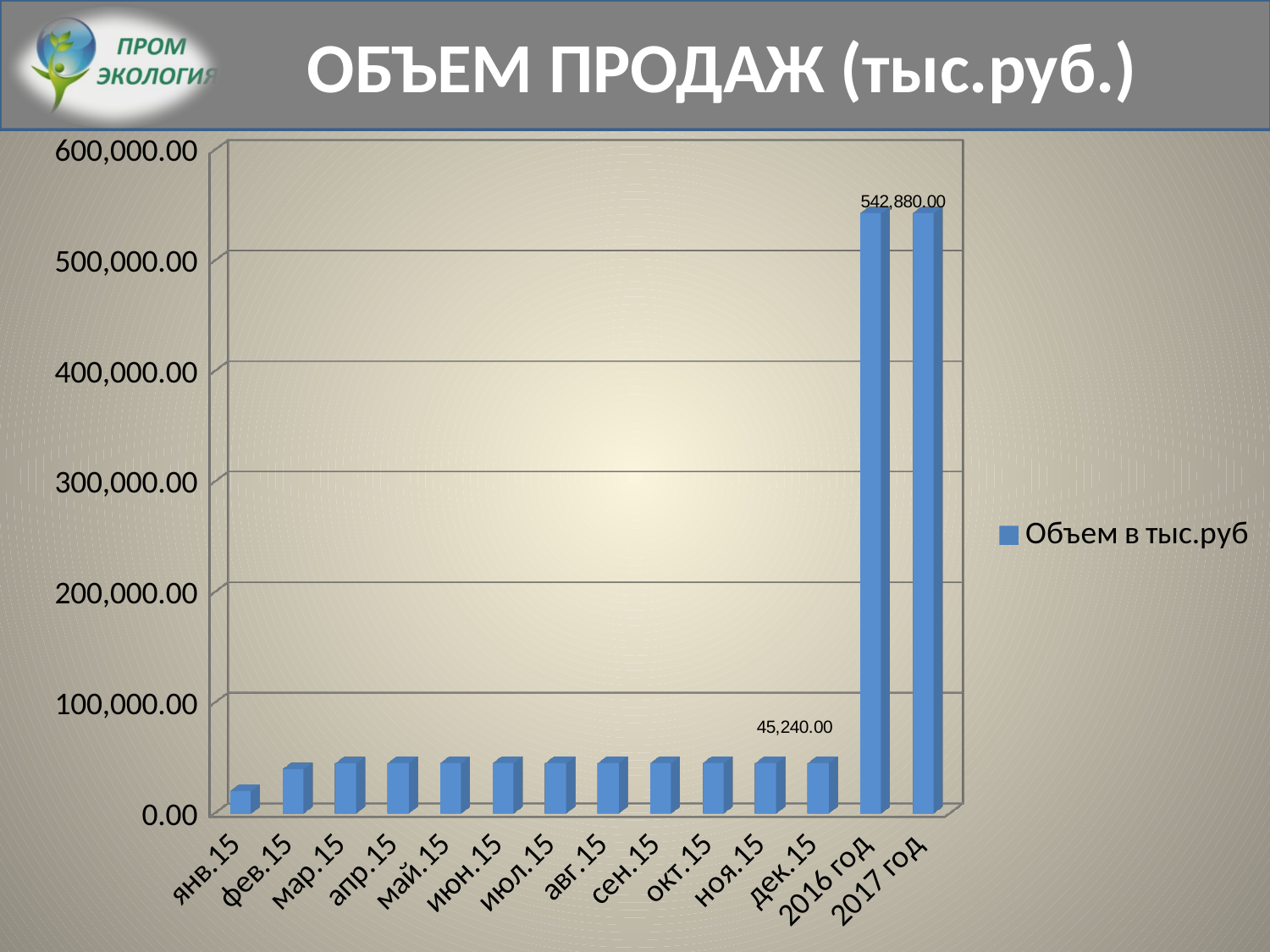
Is the value for 2017 год greater or less than 500,000.00? greater Is the value for июн.15 greater or less than 100,000.00? less What kind of chart is shown on the slide? bar chart Which is larger, the value for 2016 год or the value for дек.15? 2016 год Is the value for янв.15 greater or less than 100,000.00? less What is the title of the slide chart? ОБЪЕМ ПРОДАЖ (тыс.руб.) How many series does the chart legend list? 1 What value is printed as the data label next to the tallest bars in the chart? 542,880.00 What is the legend entry of the chart? Объем в тыс.руб How many categories are shown along the x axis of the chart? 14 Which category has the lowest value in the chart? янв.15 What is the smaller of the two data label values printed on the chart? 45,240.00